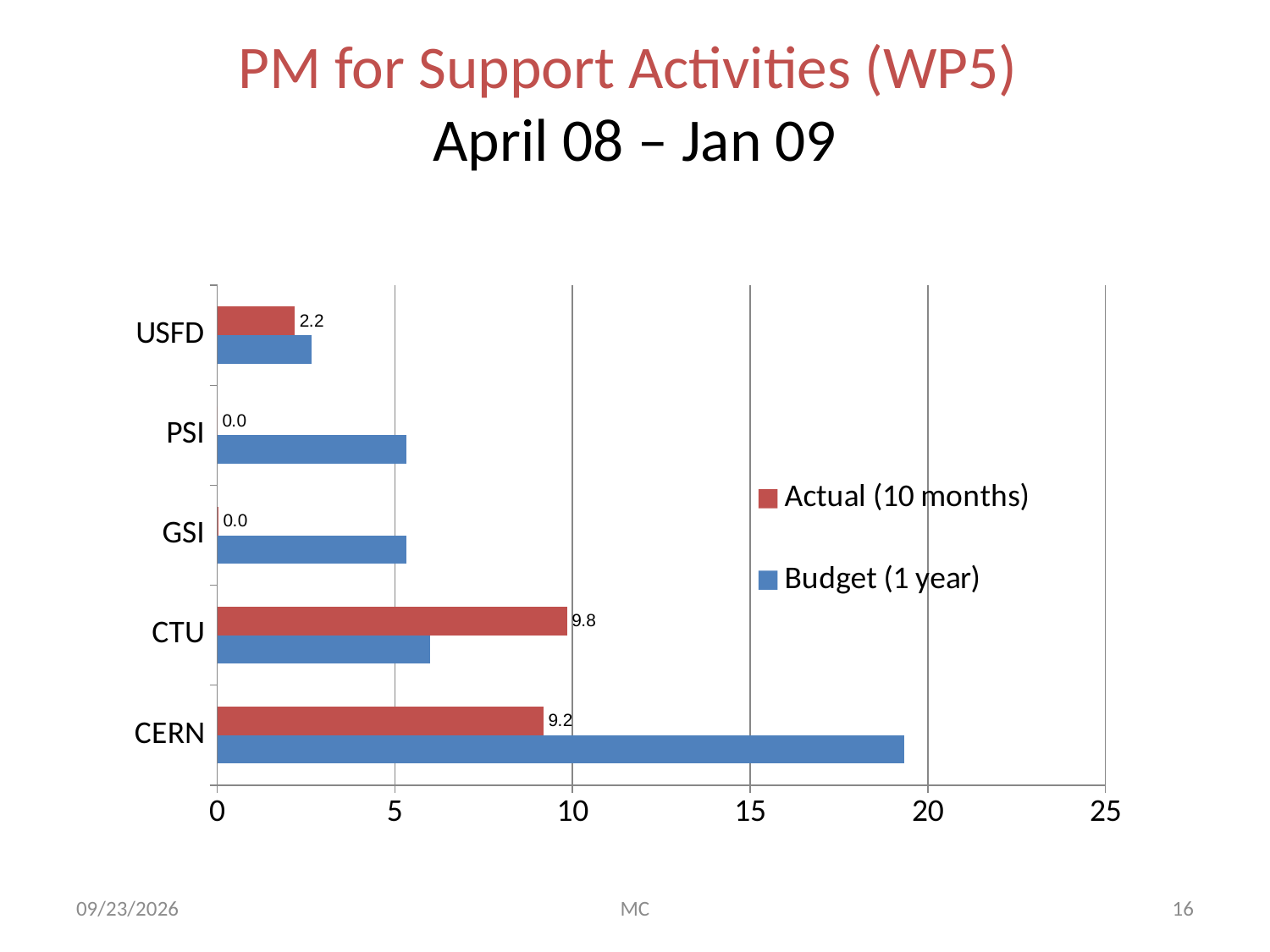
Which is larger for CERN: the Actual (10 months) bar or the Budget (1 year) bar? Budget (1 year) Which series is shown in blue in the legend? Budget (1 year) Is the Budget (1 year) value for USFD greater or less than 5? less Is the Budget (1 year) value for CERN greater or less than 15? greater Which category has the highest Actual (10 months) value? CTU What is the difference between the Actual (10 months) values for CTU and CERN? 0.6 What kind of chart is shown on the slide? bar chart How many categories are shown on the chart? 5 What is the Actual (10 months) value for CTU? 9.8 How many series does the legend list? 2 What is the Actual (10 months) value for CERN? 9.2 What is the Actual (10 months) value for USFD? 2.2